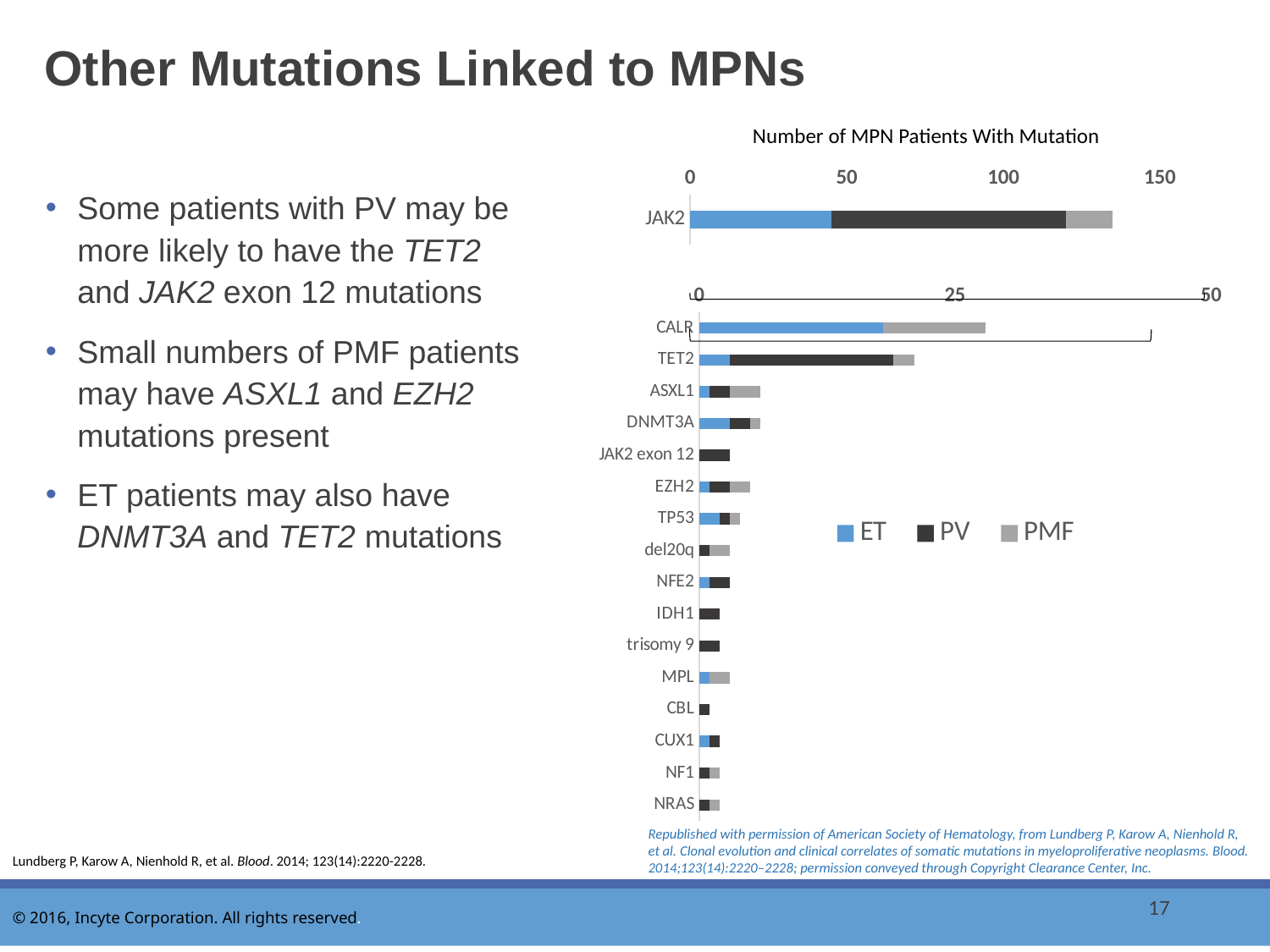
Which series is shown in blue in the legend? ET What kind of chart is shown on the slide? Stacked bar chart In the lower chart (axis 0 to 50), which mutation has the lowest total number of patients? CBL How many series does the legend list? 3 In the lower chart (axis 0 to 50), which has a larger total: CALR or TET2? CALR In the lower chart (axis 0 to 50), which mutation has the highest total number of patients? CALR What is the title of the chart on the slide? Number of MPN Patients With Mutation In the upper chart (axis 0 to 150), is the total value for JAK2 greater or less than 150? less In the upper chart (axis 0 to 150), is the total value for JAK2 greater or less than 100? greater In the lower chart (axis 0 to 50), how many mutation categories are plotted? 16 In the upper chart (axis 0 to 150), which series makes up the largest part of the JAK2 bar? PV In the lower chart (axis 0 to 50), is the total value for TET2 greater or less than 25? less